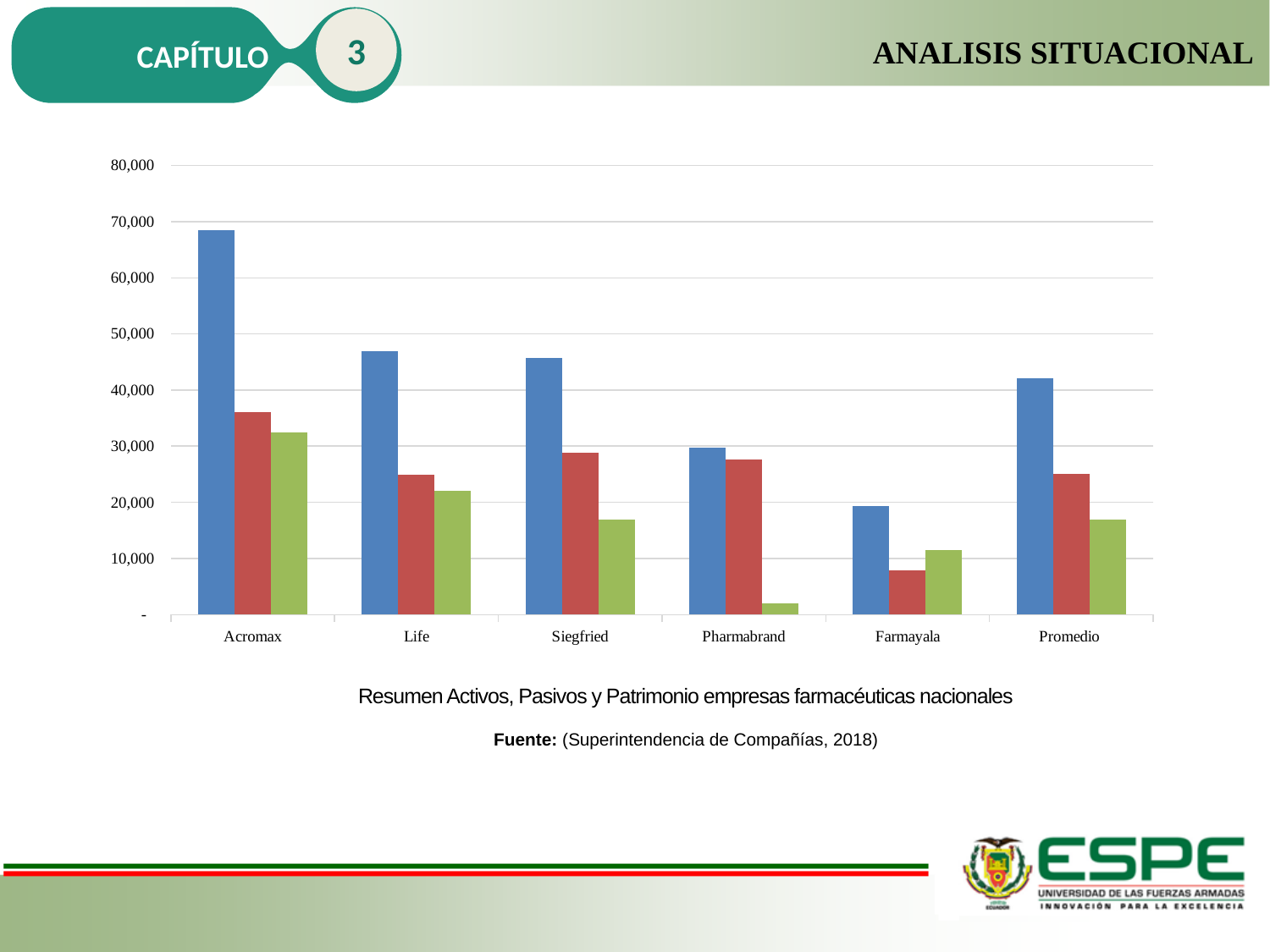
Which category has the shortest green bar in the chart? Pharmabrand What is the source cited below the chart? Superintendencia de Compañías, 2018 How many bars are plotted for each category in the chart? 3 Is the red bar for Acromax greater or less than 30,000? greater Is the green bar for Pharmabrand greater or less than 10,000? less Which category has the tallest blue bar in the chart? Acromax Is the blue bar for Life greater or less than 50,000? less What kind of chart is shown on the slide? Bar chart For Farmayala, which bar is taller: the red bar or the green bar? The green bar Which category has the shortest blue bar in the chart? Farmayala How many categories are shown along the x axis of the chart? 6